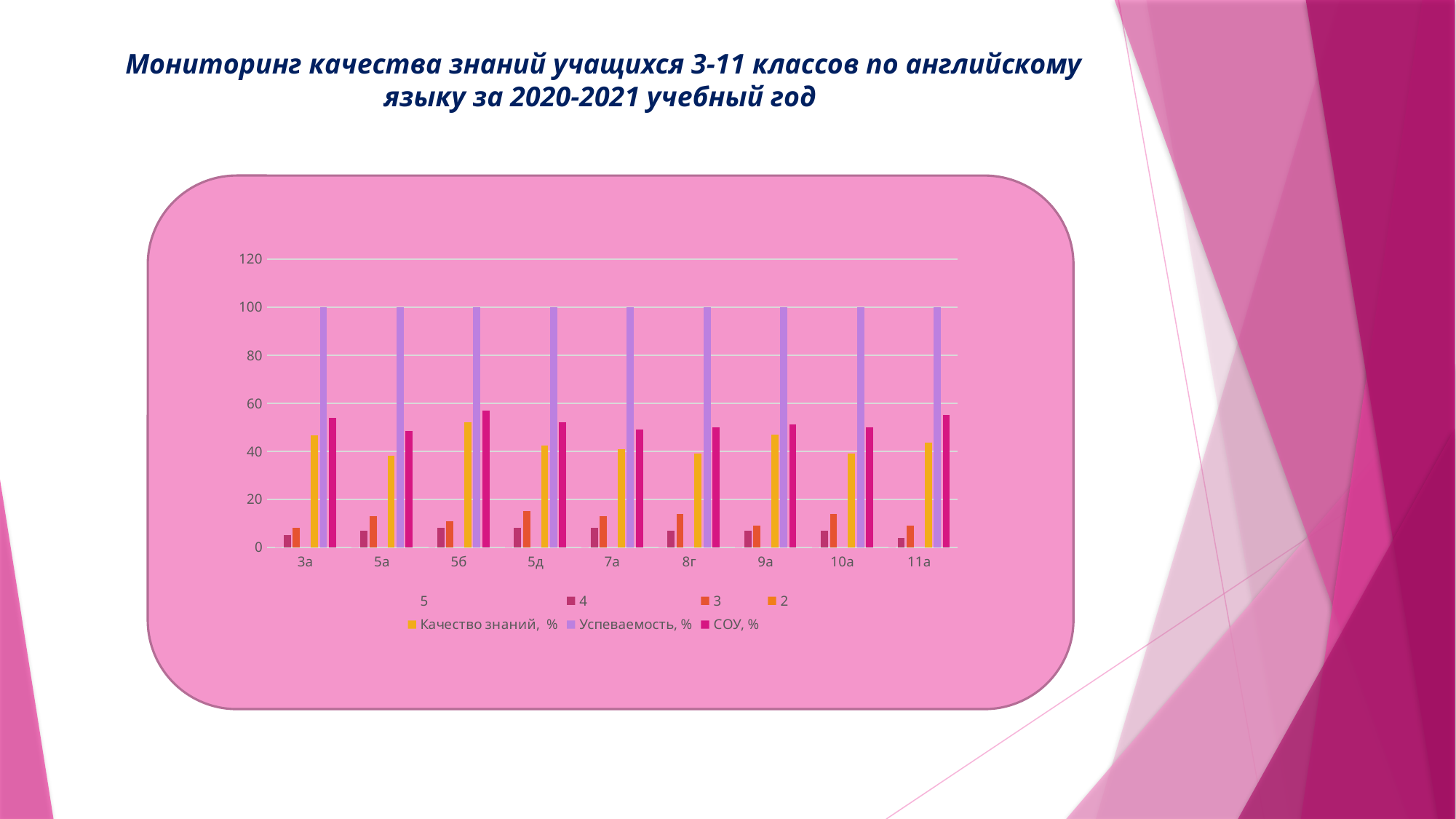
Is the value of СОУ, % for class 3а greater or less than 40? greater Which class has the larger value of Качество знаний, %: 5а or 5б? 5б What kind of chart is shown on the slide? bar chart Is the value of Качество знаний, % for class 5б greater or less than 40? greater Which class has the highest value for Качество знаний, %? 5б Is the value of Качество знаний, % for class 8г greater or less than 60? less Which is larger for class 5д: the value of series 3 or the value of series 4? 3 What is the value of Успеваемость, % for class 11а? 100 What is the value of Успеваемость, % for class 3а? 100 How many classes (categories) are shown on the x axis of the chart? 9 How many series does the chart's legend list? 7 What is the title of the slide containing the chart? Мониторинг качества знаний учащихся 3-11 классов по английскому языку за 2020-2021 учебный год